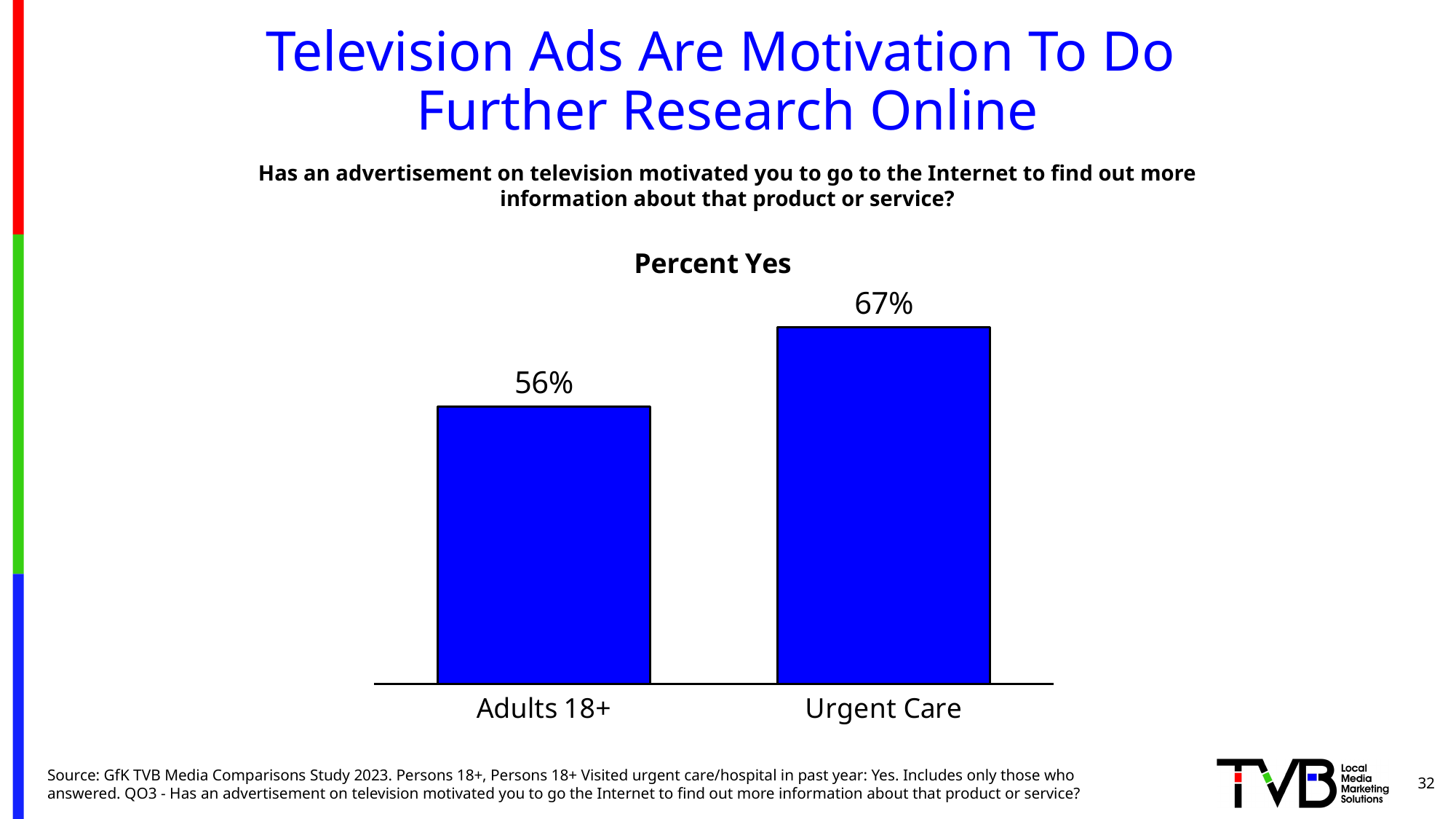
Which category has the lowest Percent Yes value? Adults 18+ How many categories are shown in the chart? 2 Which is larger, the Percent Yes for Adults 18+ or for Urgent Care? Urgent Care Which category has the highest Percent Yes value? Urgent Care What is the difference in Percent Yes between Urgent Care and Adults 18+? 11% What is the title of the chart? Percent Yes What colour are the bars in the chart? Blue What is the Percent Yes value for Adults 18+? 56% What is the Percent Yes value for Urgent Care? 67% What kind of chart is shown on the slide? Bar chart